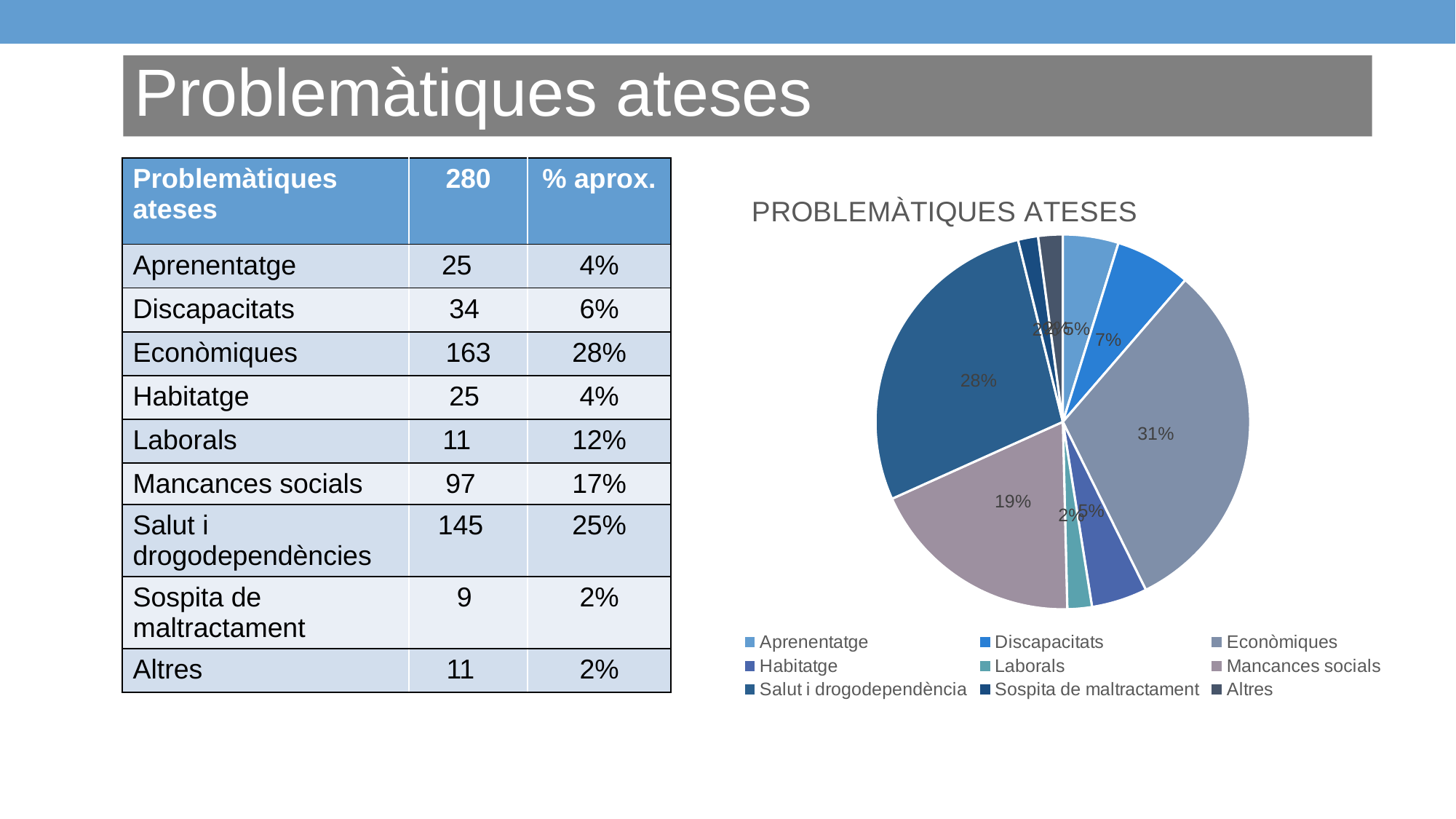
What percentage does the pie chart show for Mancances socials? 19% Which category is listed first in the pie chart's legend? Aprenentatge Which category has the largest slice in the pie chart? Econòmiques What is the title of the pie chart? PROBLEMÀTIQUES ATESES What percentage does the pie chart show for Discapacitats? 7% What kind of chart is shown on the slide? Pie chart In the pie chart, which slice is larger, Mancances socials or Discapacitats? Mancances socials In the pie chart, what is the difference between the Econòmiques share and the Mancances socials share? 12% What percentage does the pie chart show for Econòmiques? 31% How many categories does the pie chart's legend list? 9 In the pie chart, which slice is larger, Econòmiques or Salut i drogodependència? Econòmiques What percentage does the pie chart show for Salut i drogodependència? 28%